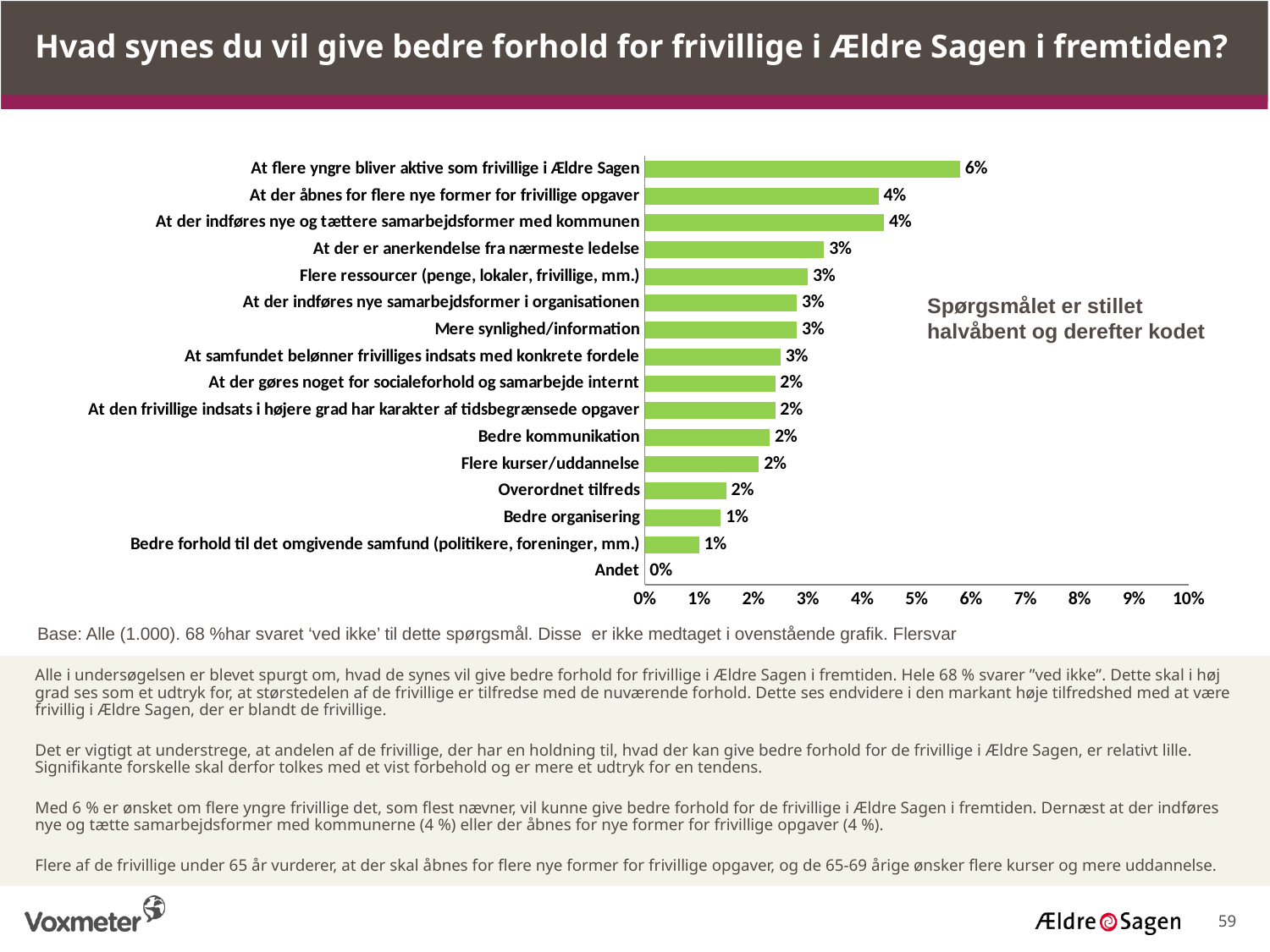
Which category has the lowest value? Andet What is the value for 'At der indføres nye og tættere samarbejdsformer med kommunen'? 4% What is the value for 'At flere yngre bliver aktive som frivillige i Ældre Sagen'? 6% Is the value for 'At flere yngre bliver aktive som frivillige i Ældre Sagen' greater or less than 5%? greater What is the value for 'Bedre organisering'? 1% Which is larger: the value for 'Mere synlighed/information' or the value for 'Overordnet tilfreds'? Mere synlighed/information What is the value for 'Andet'? 0% Which category has the highest value? At flere yngre bliver aktive som frivillige i Ældre Sagen How many categories are shown in the chart? 16 What is the difference between the value for 'At flere yngre bliver aktive som frivillige i Ældre Sagen' and the value for 'At der åbnes for flere nye former for frivillige opgaver'? 2 percentage points What kind of chart is shown on the slide? Bar chart What is the value for 'Flere kurser/uddannelse'? 2%